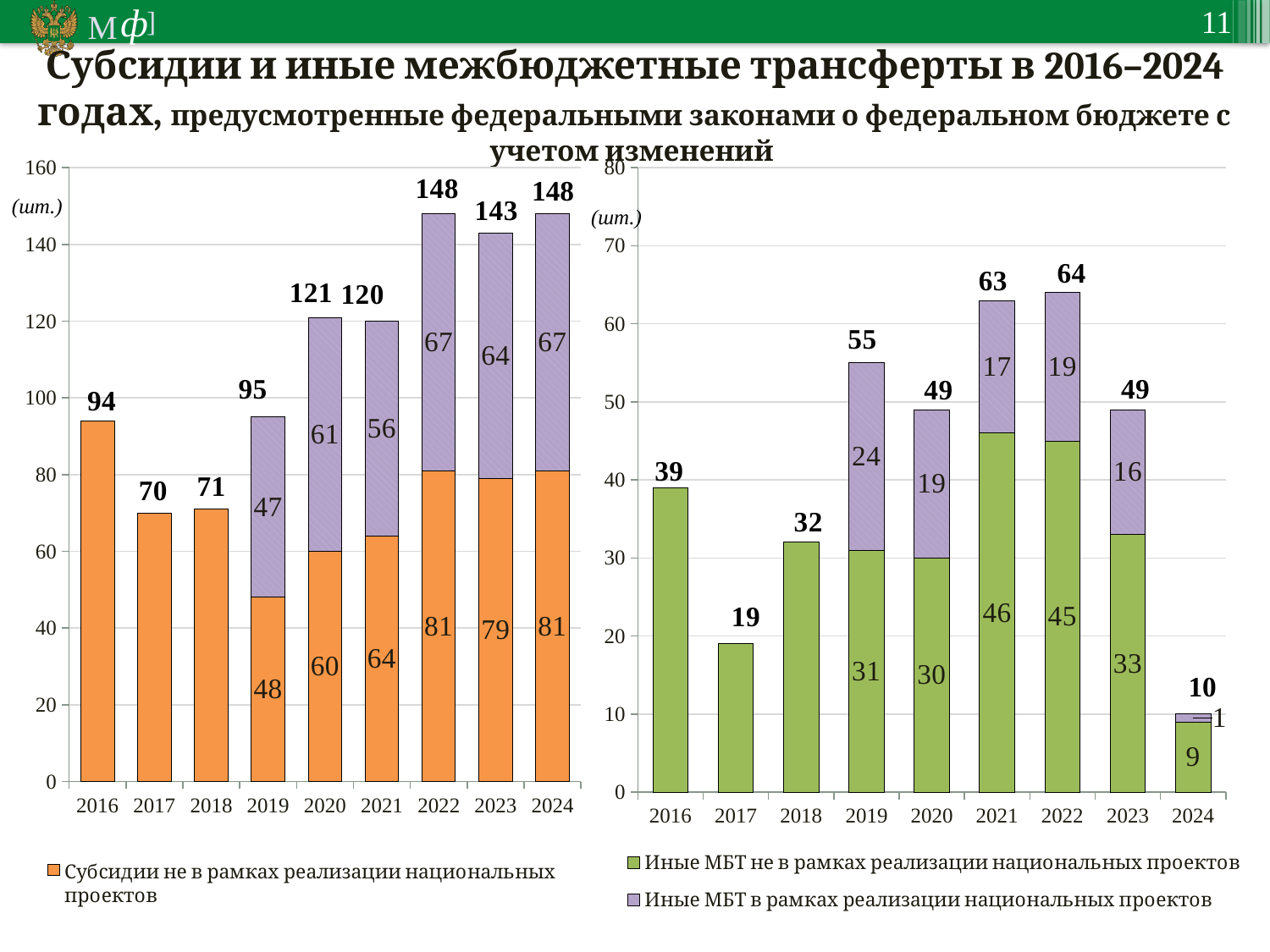
In the right chart, what is the total value shown for 2024? 10 How many series does the legend of the right chart list? 2 In the left chart, what is the value of the orange segment (Субсидии не в рамках реализации национальных проектов) for 2019? 48 In the right chart, which year has the highest total value? 2022 How many years are shown on the x axis of the right chart? 9 In the right chart, which is larger: the total for 2019 or the total for 2020? 2019 In the left chart, which year has the lowest total value? 2017 In the left chart, is the total for 2021 greater or less than 100? greater In the left chart, what is the difference between the totals for 2024 and 2016? 54 In the right chart, what is the value of the green segment (Иные МБТ не в рамках реализации национальных проектов) for 2021? 46 In the right chart, what is the difference between the purple segment values for 2019 and 2023? 8 In the left chart, what is the total value shown for 2022? 148